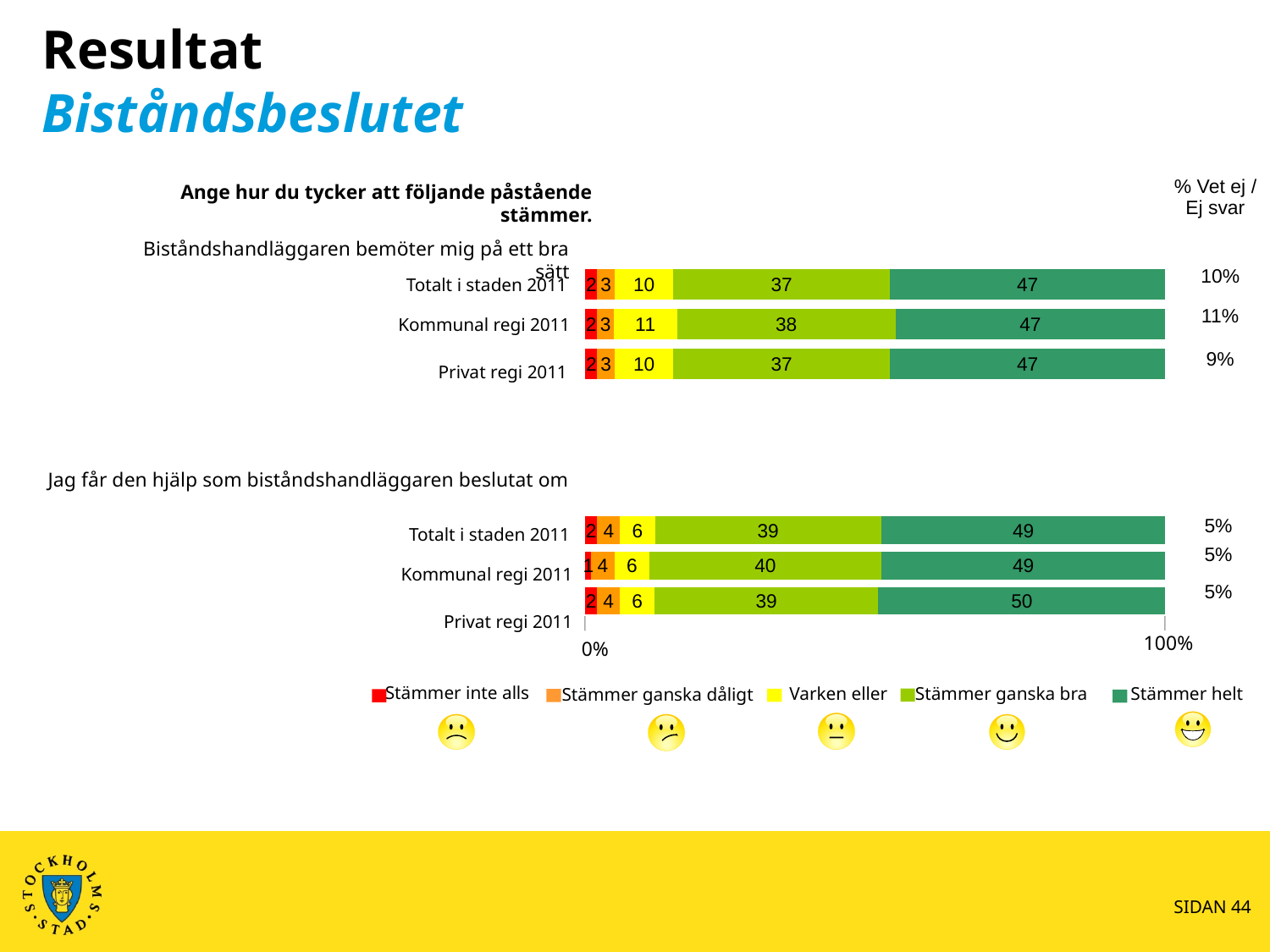
What kind of chart is used on this slide? Stacked bar chart How many categories are shown in the chart 'Biståndshandläggaren bemöter mig på ett bra sätt'? 3 In the chart 'Jag får den hjälp som biståndshandläggaren beslutat om', what is the value of 'Stämmer helt' for 'Privat regi 2011'? 50 How many series does the legend list? 5 In the chart 'Jag får den hjälp som biståndshandläggaren beslutat om', which category has the highest 'Stämmer helt' value? Privat regi 2011 In the chart 'Biståndshandläggaren bemöter mig på ett bra sätt', what is the value of 'Stämmer helt' for 'Totalt i staden 2011'? 47 What is the '% Vet ej / Ej svar' value shown for 'Privat regi 2011' in the chart 'Biståndshandläggaren bemöter mig på ett bra sätt'? 9% In the chart 'Jag får den hjälp som biståndshandläggaren beslutat om', what is the value of 'Stämmer ganska bra' for 'Kommunal regi 2011'? 40 In the chart 'Jag får den hjälp som biståndshandläggaren beslutat om', which is larger for 'Totalt i staden 2011': 'Stämmer ganska bra' or 'Stämmer helt'? Stämmer helt Which legend entry is shown in dark green? Stämmer helt In the chart 'Biståndshandläggaren bemöter mig på ett bra sätt', what is the value of 'Varken eller' for 'Kommunal regi 2011'? 11 In the chart 'Biståndshandläggaren bemöter mig på ett bra sätt', what is the difference between 'Stämmer helt' and 'Stämmer ganska bra' for 'Totalt i staden 2011'? 10